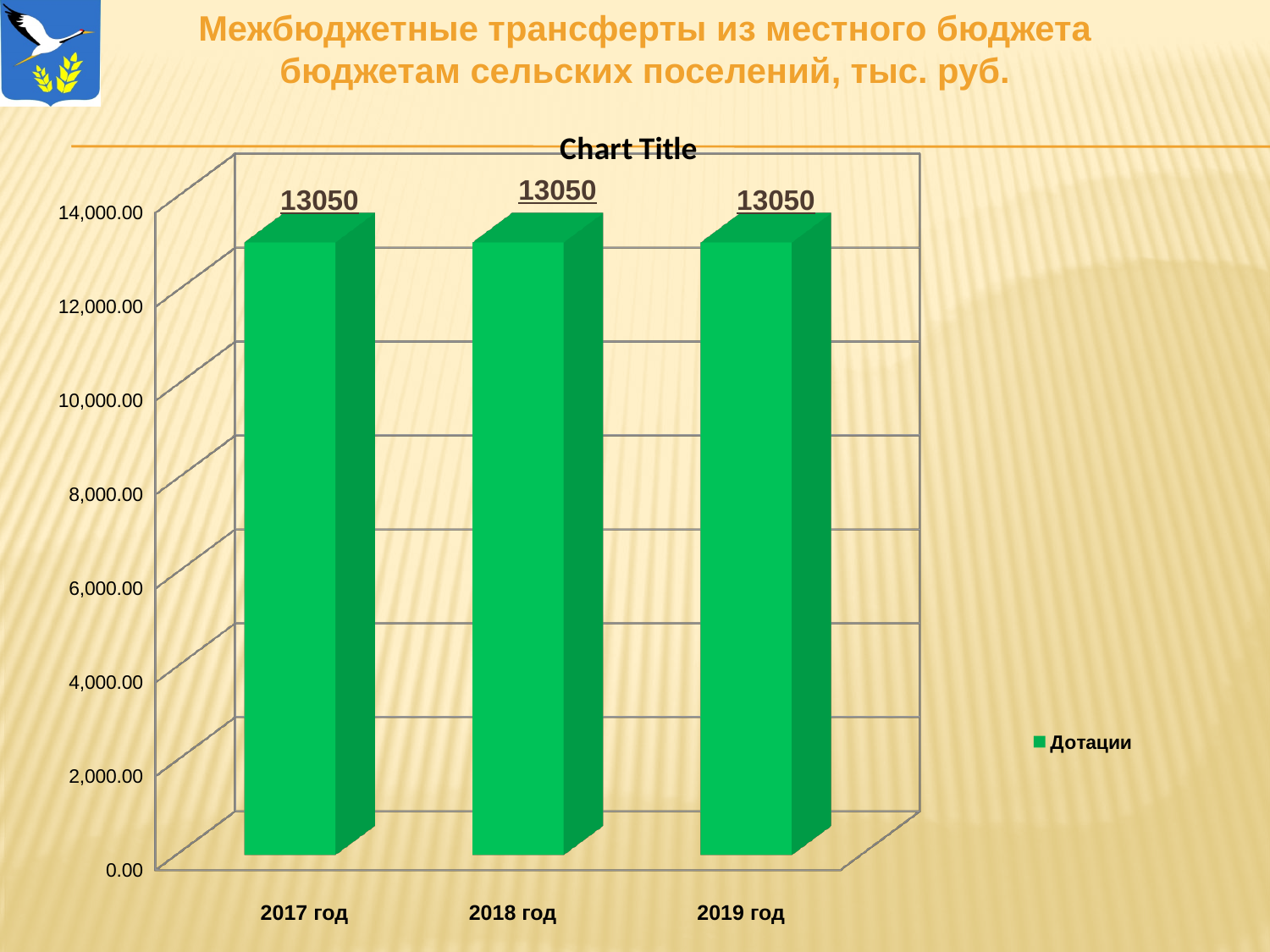
Is the value for 2018 год greater or less than 12,000.00? greater What is the value for 2019 год? 13050 What kind of chart is shown on the slide? bar chart Is the value for 2019 год greater or less than 14,000.00? less What is the title shown above the plot area of the chart? Chart Title What is the value for 2018 год? 13050 What is the difference between the values for 2017 год and 2019 год? 0 How many categories are shown on the x axis? 3 What series name is listed in the legend? Дотации What is the value for 2017 год? 13050 How many series does the legend list? 1 Do the values rise, fall or stay the same from 2017 год to 2019 год? stay the same